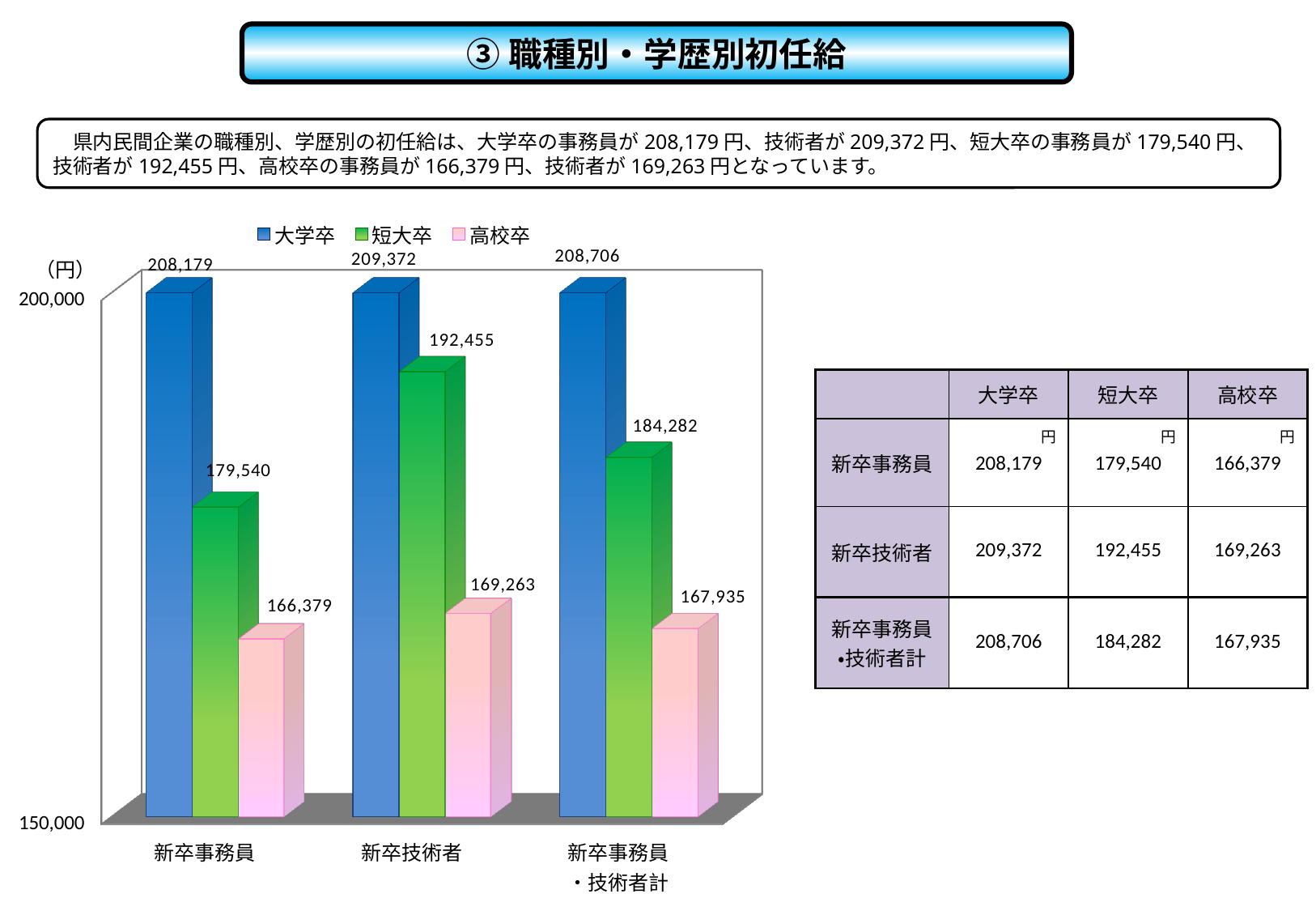
Which category has the highest value for 大学卒? 新卒技術者 Is the 短大卒 value for 新卒事務員・技術者計 greater or less than 200,000? less What kind of chart is shown on the slide? bar chart What is the difference between the 短大卒 values for 新卒技術者 and 新卒事務員? 12,915 What is the difference between the 大学卒 and 短大卒 values in the 新卒事務員 category? 28,639 Which category has the lowest value for 高校卒? 新卒事務員 What is the value for 大学卒 in the 新卒事務員 category? 208,179 How many categories are shown on the x axis of the chart? 3 Which is larger: the 高校卒 value for 新卒技術者 or for 新卒事務員? 新卒技術者 How many series does the chart legend list? 3 What is the value for 短大卒 in the 新卒技術者 category? 192,455 What is the value for 高校卒 in the 新卒事務員・技術者計 category? 167,935